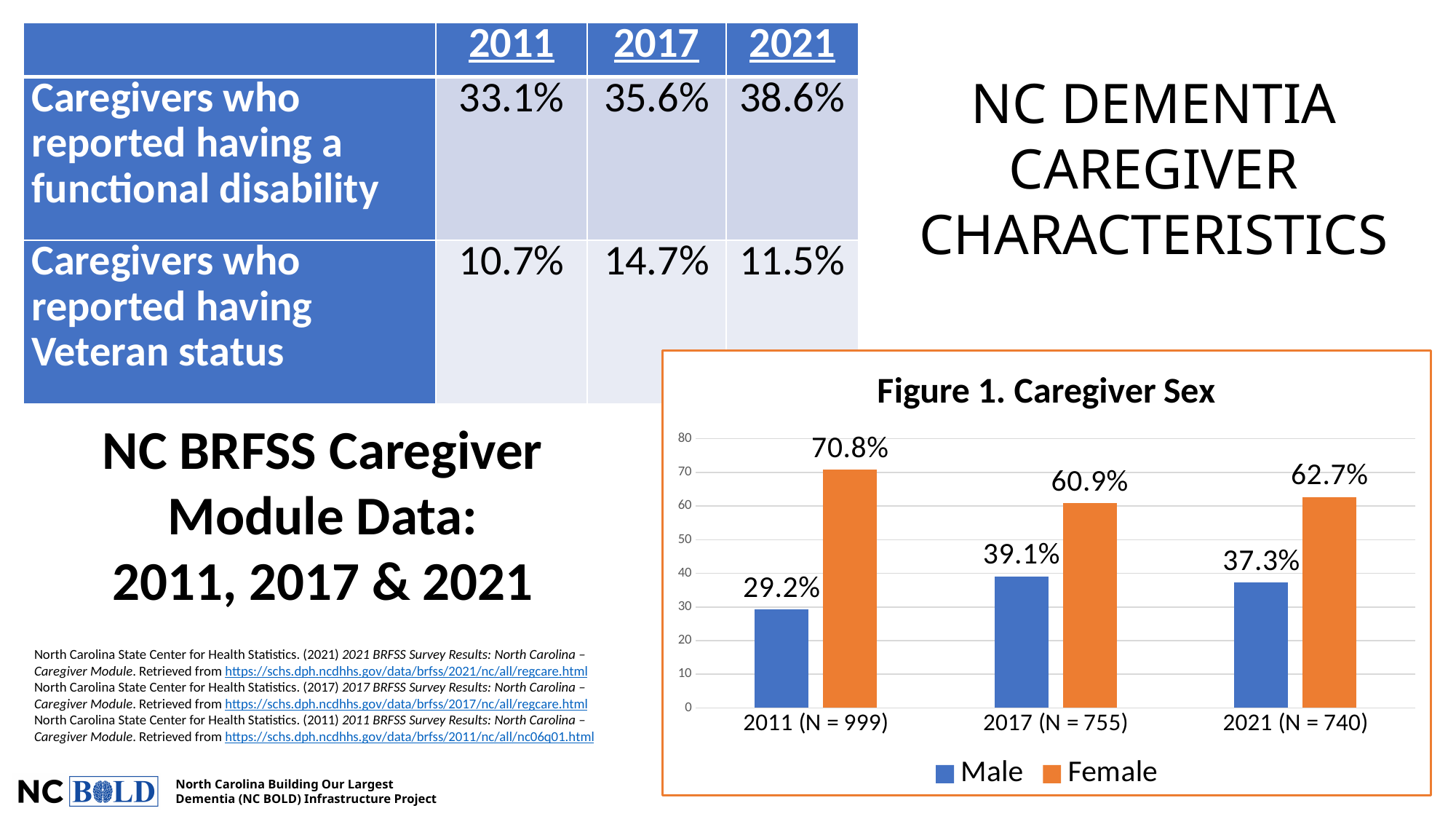
How many year categories are shown on the x axis of Figure 1. Caregiver Sex? 3 What kind of chart is Figure 1. Caregiver Sex? bar chart In Figure 1. Caregiver Sex, which year has the highest Female value? 2011 (N = 999) In Figure 1. Caregiver Sex, is the Male value for 2011 (N = 999) greater or less than 30? less What is the Male value for 2017 (N = 755) in Figure 1. Caregiver Sex? 39.1% In Figure 1. Caregiver Sex, which year has the lowest Male value? 2011 (N = 999) What is the Female value for 2011 (N = 999) in Figure 1. Caregiver Sex? 70.8% In Figure 1. Caregiver Sex, which colour represents the Female series? orange What is the Male value for 2021 (N = 740) in Figure 1. Caregiver Sex? 37.3% In Figure 1. Caregiver Sex, is the Female value for 2017 (N = 755) larger or smaller than the Female value for 2021 (N = 740)? smaller In Figure 1. Caregiver Sex, what is the difference between the Female and Male values for 2021 (N = 740)? 25.4% How many series does the legend of Figure 1. Caregiver Sex list? 2